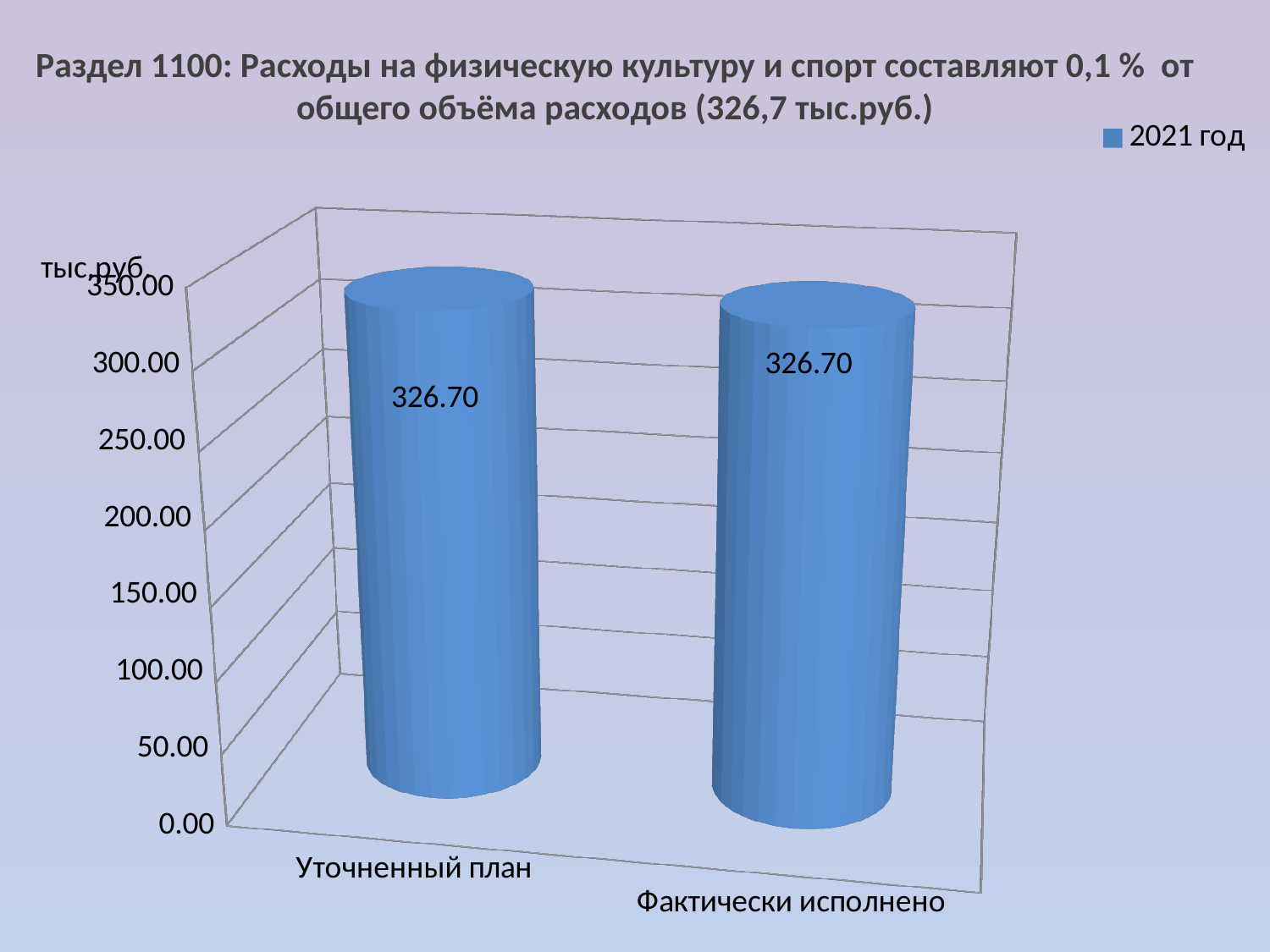
Do the values rise, fall or stay the same from Уточненный план to Фактически исполнено? stay the same How many series does the legend list? 1 What unit label is shown next to the vertical axis? тыс.руб What is the difference between the values for Уточненный план and Фактически исполнено? 0.00 What is the value for Фактически исполнено? 326.70 What series name is shown in the legend? 2021 год What is the value for Уточненный план? 326.70 Is the value for Уточненный план greater or less than 300.00? greater What kind of chart is shown on the slide? bar chart How many categories are shown on the x axis? 2 Is the value for Фактически исполнено greater or less than 350.00? less